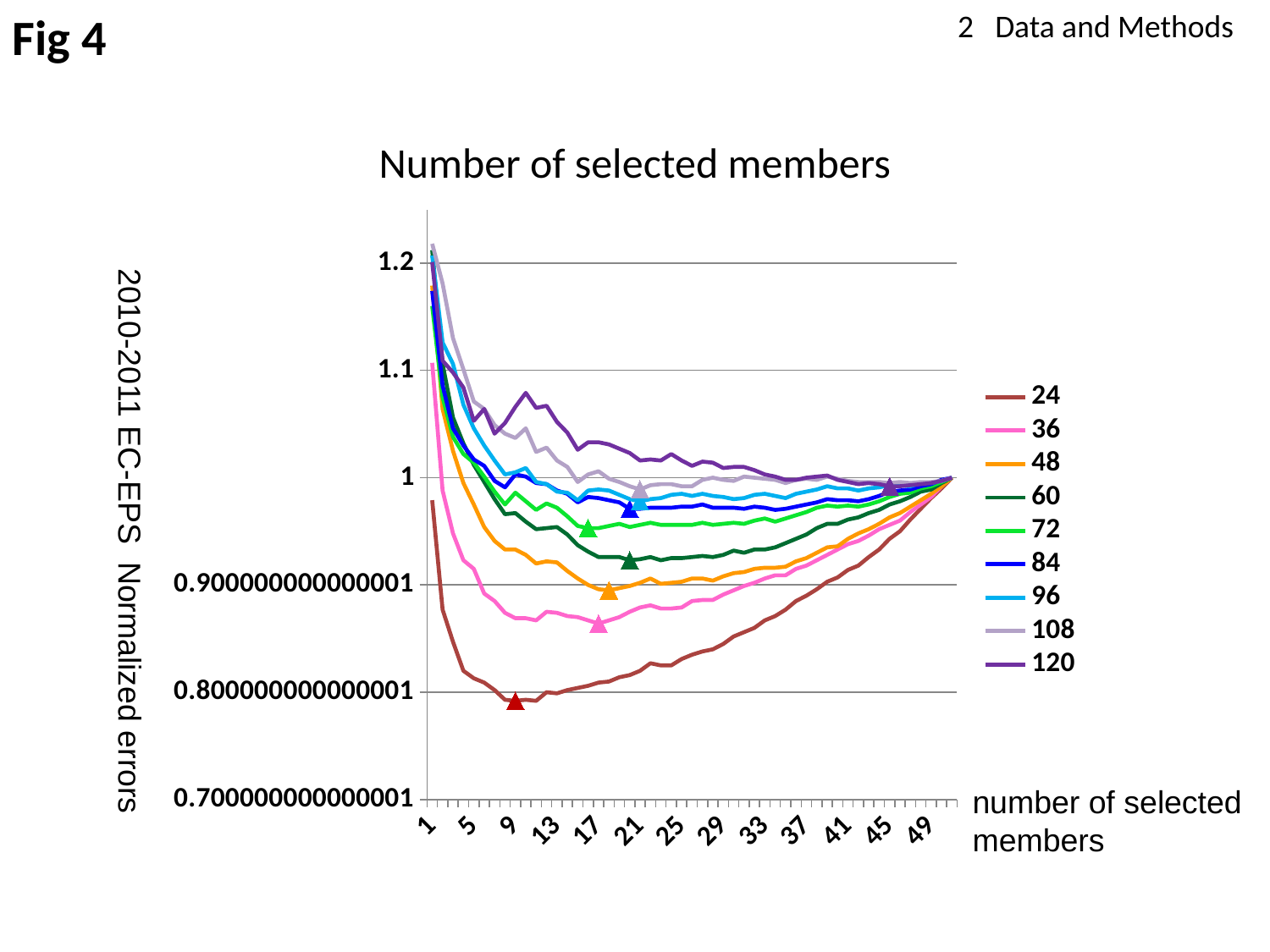
Is the value for series 120 at x = 1 greater or less than 1.1? greater Which series is highest at x = 13? 120 What is the title of the chart? Number of selected members Which series reaches the lowest normalized error on the chart? 24 At x = 25, which series has the higher value, 24 or 36? 36 Is the value for series 120 at x = 13 greater or less than 1? greater What is the label on the vertical axis of the chart? 2010-2011 EC-EPS Normalized errors Is the value for series 36 at x = 17 greater or less than 0.9? less How many series does the legend list? 9 What kind of chart is shown on the slide? line chart Do the values for series 24 rise or fall from x = 1 to x = 9? fall